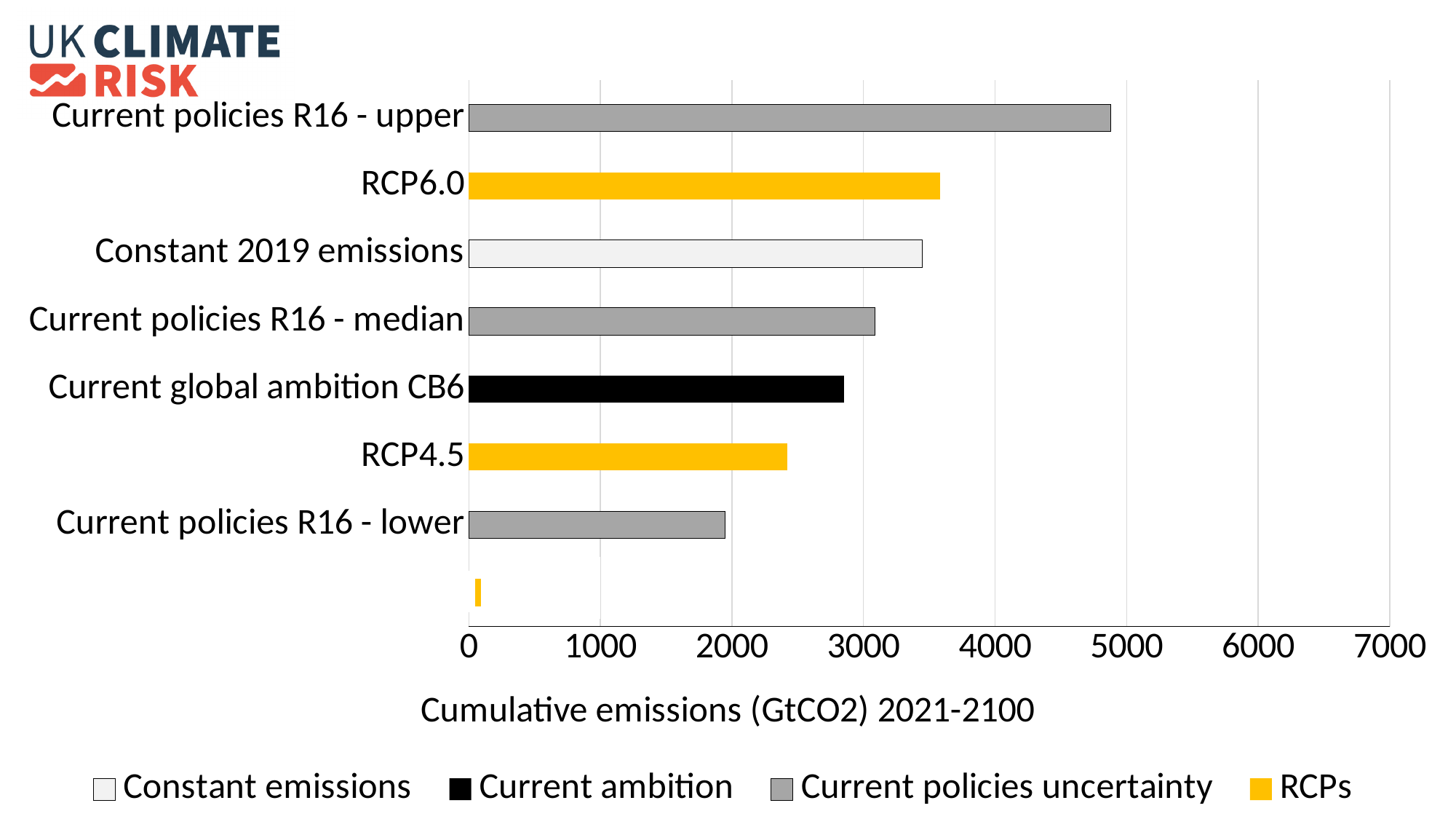
What kind of chart is shown on the slide? bar chart Is the value for Constant 2019 emissions greater or less than 4000? less Which category has the highest cumulative emissions? Current policies R16 - upper Which has the larger value, Constant 2019 emissions or Current global ambition CB6? Constant 2019 emissions How many series does the legend list? 4 Is the value for RCP6.0 greater or less than 3000? greater Is the value for Current policies R16 - upper greater or less than 4000? greater Which has the larger value, RCP6.0 or RCP4.5? RCP6.0 What is the title of the horizontal axis? Cumulative emissions (GtCO2) 2021-2100